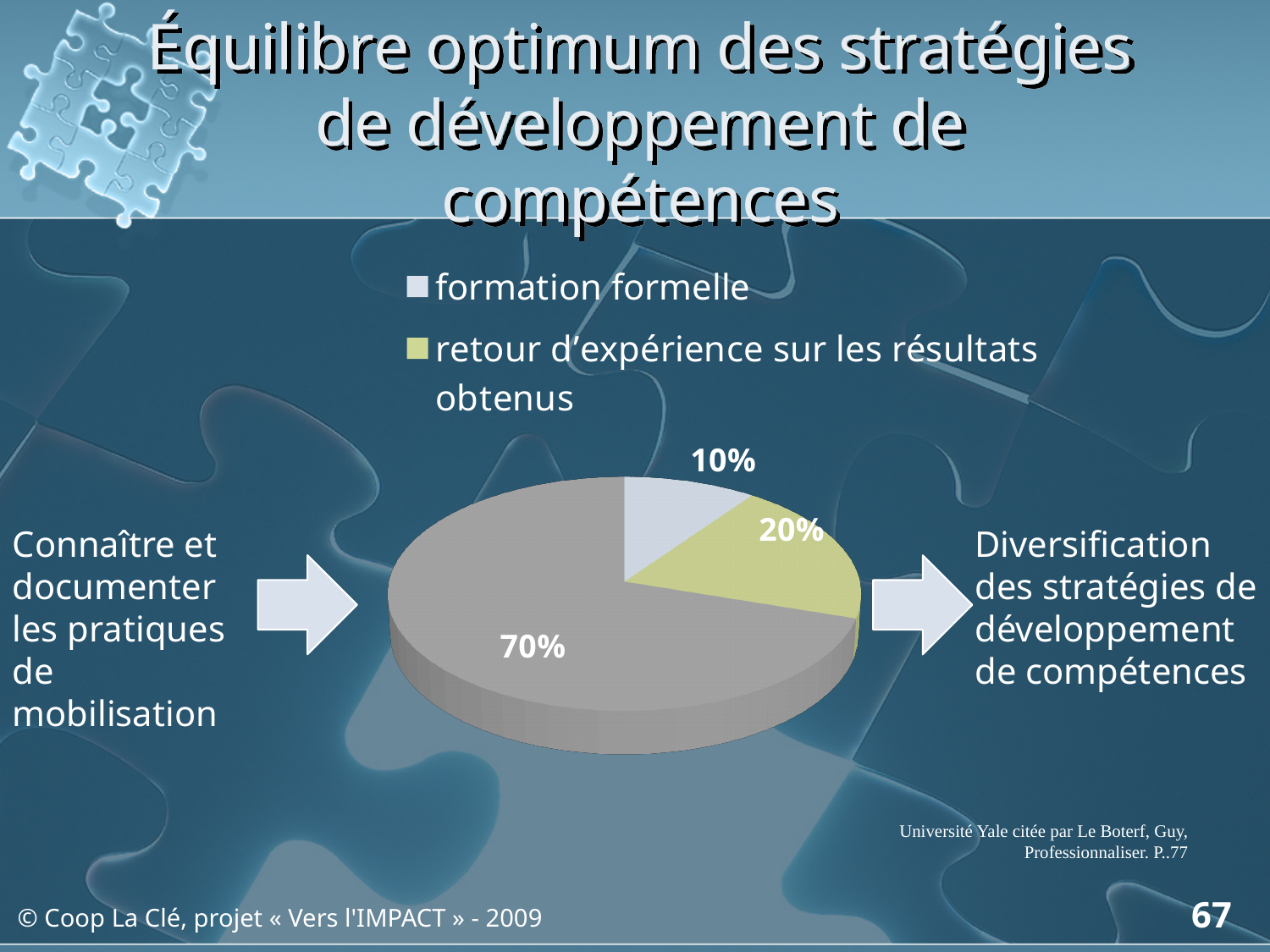
How many entries are listed in the chart legend? 2 Which slice is larger: "formation formelle" or "retour d'expérience sur les résultats obtenus"? retour d'expérience sur les résultats obtenus What kind of chart is shown on the slide? pie chart What share of the pie does the "formation formelle" slice represent? 10% Which legend category has the smallest slice of the pie? formation formelle What is the largest percentage shown on the pie chart? 70% What percentage of the pie is labelled for "retour d'expérience sur les résultats obtenus"? 20% By how many percentage points does the "retour d'expérience sur les résultats obtenus" slice exceed the "formation formelle" slice? 10 percentage points How many slices does the pie chart have? 3 What colour is the largest slice of the pie chart? grey What percentage of the pie is labelled for "formation formelle"? 10% What is the smallest percentage shown on the pie chart? 10%